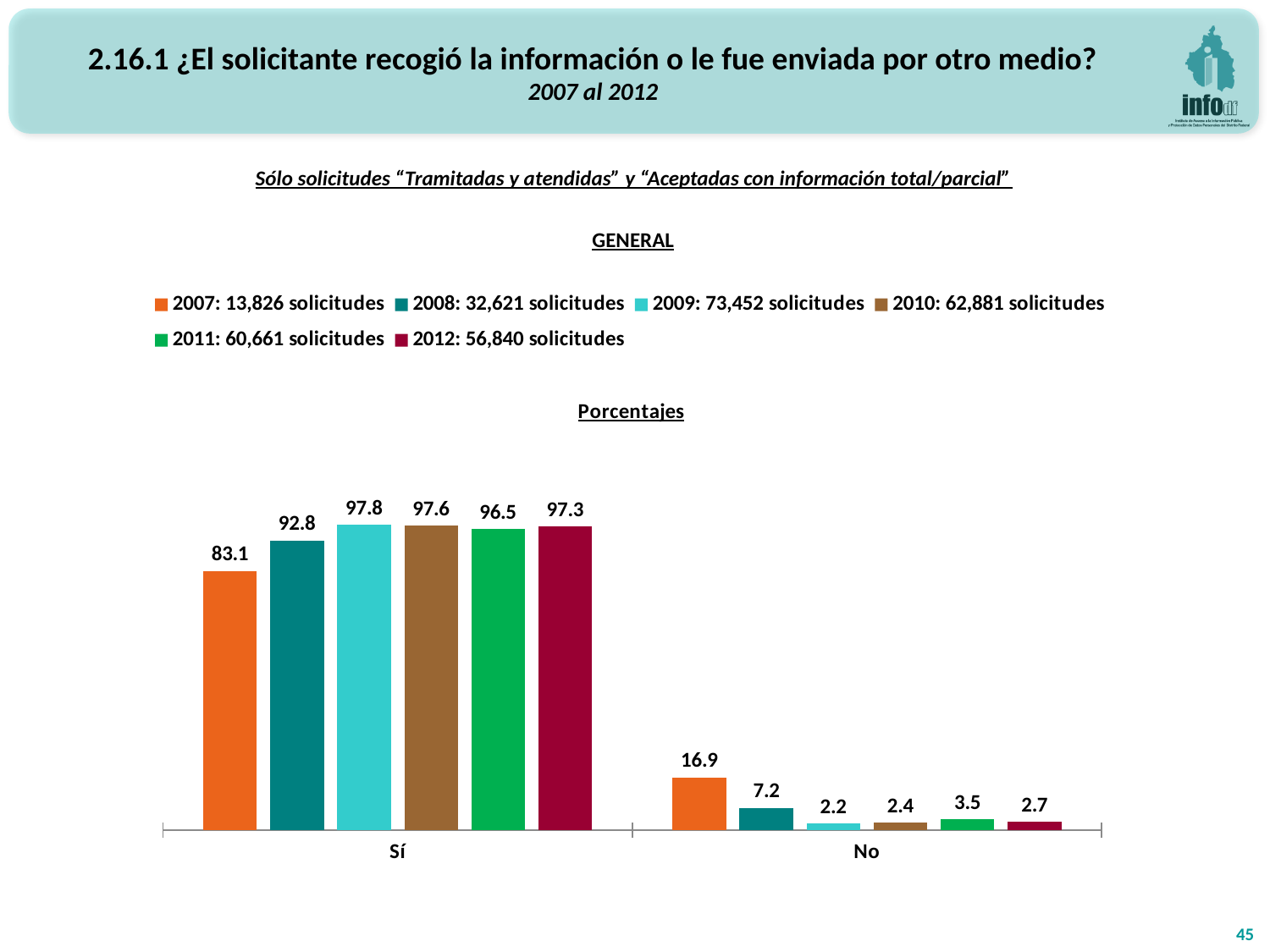
What is the value for 2012 in the Sí category? 97.3 What is the difference between the 2007 and 2008 values in the Sí category? 9.7 What is the value for 2007 in the Sí category? 83.1 According to the legend, how many solicitudes were there in 2009? 73,452 How many categories are shown on the x axis? 2 What is the value for 2009 in the No category? 2.2 How many series does the legend list? 6 What kind of chart is shown on the slide? bar chart Which year has the highest value in the No category? 2007 Which year has the lowest value in the No category? 2009 Which is larger: the 2011 value or the 2010 value in the No category? 2011 Which year has the highest value in the Sí category? 2009